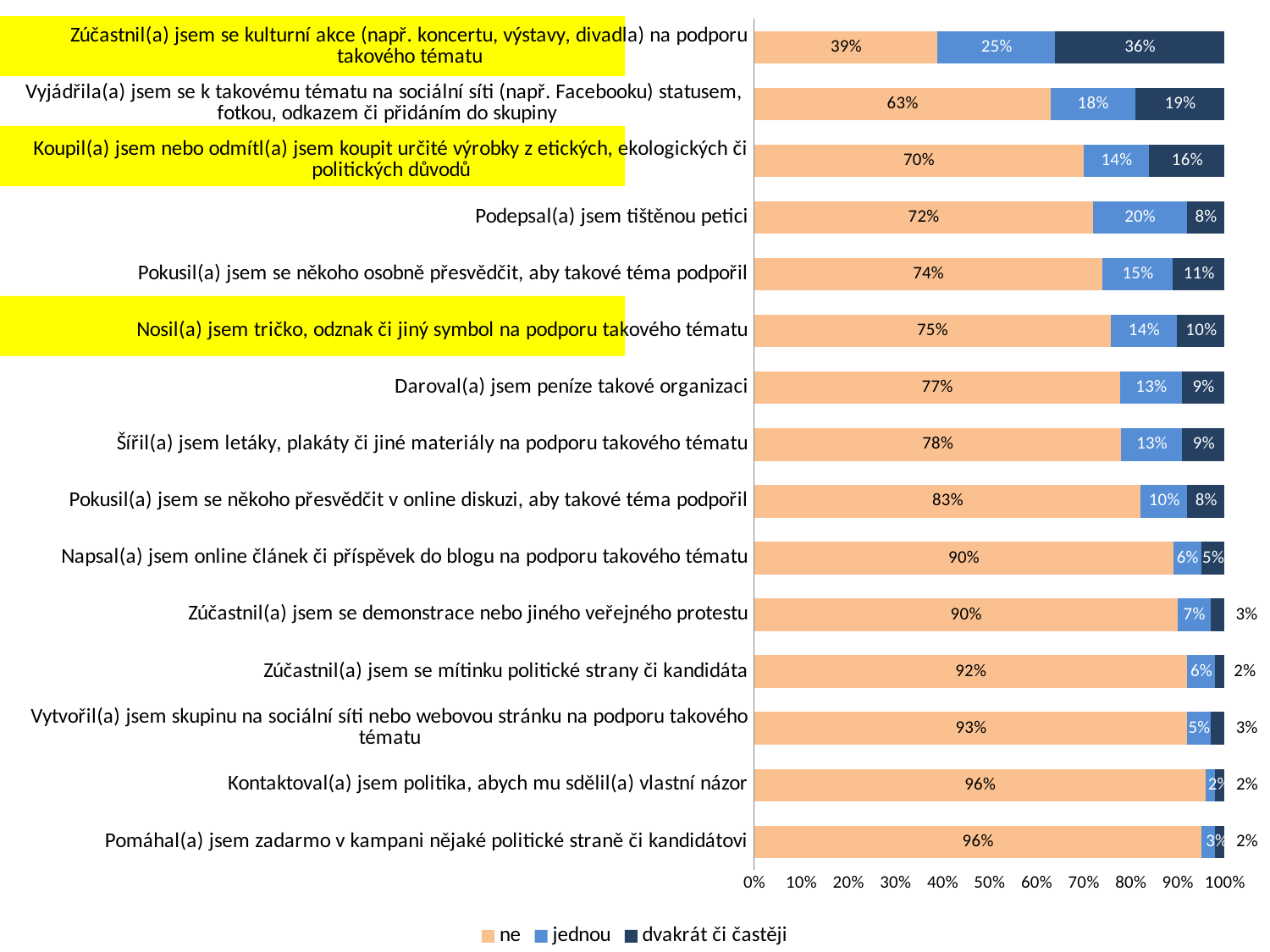
What is the value of the "dvakrát či častěji" series for "Zúčastnil(a) jsem se kulturní akce (např. koncertu, výstavy, divadla) na podporu takového tématu"? 36% What is the value of the "ne" series for "Kontaktoval(a) jsem politika, abych mu sdělil(a) vlastní názor"? 96% What are the three series names listed in the legend? ne, jednou, dvakrát či častěji How many categories (activities) are plotted in the chart? 15 What is the difference between the "ne" values for "Koupil(a) jsem nebo odmítl(a) jsem koupit určité výrobky z etických, ekologických či politických důvodů" and "Vyjádřila(a) jsem se k takovému tématu na sociální síti (např. Facebooku) statusem, fotkou, odkazem či přidáním do skupiny"? 7% Which category has the lowest value for the "ne" series? Zúčastnil(a) jsem se kulturní akce (např. koncertu, výstavy, divadla) na podporu takového tématu How many series does the legend list? 3 Which is larger: the "dvakrát či častěji" value for "Podepsal(a) jsem tištěnou petici" or for "Pokusil(a) jsem se někoho osobně přesvědčit, aby takové téma podpořil"? Pokusil(a) jsem se někoho osobně přesvědčit, aby takové téma podpořil What is the value of the "ne" series for "Podepsal(a) jsem tištěnou petici"? 72% What kind of chart is shown on the slide? stacked bar chart What is the value of the "jednou" series for "Daroval(a) jsem peníze takové organizaci"? 13% Which category has the highest value for the "jednou" series? Zúčastnil(a) jsem se kulturní akce (např. koncertu, výstavy, divadla) na podporu takového tématu